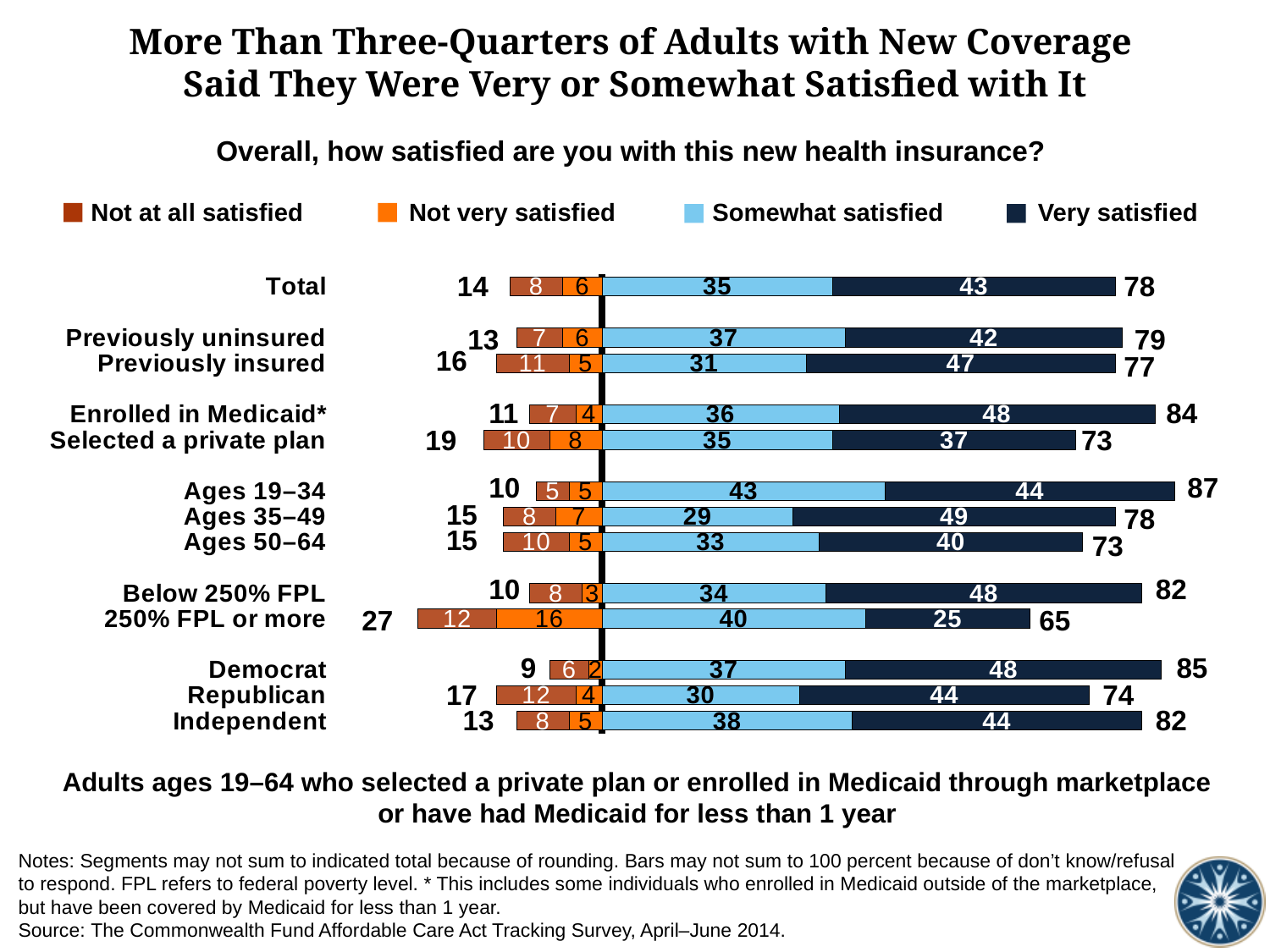
How many groups (bars) are shown in the chart? 13 What is the difference between the very satisfied percentages for Democrats and Republicans? 4 What type of chart is shown on the slide? Stacked bar chart Which group has the highest combined share of very or somewhat satisfied respondents? Ages 19–34 Which group has the lowest combined share of very or somewhat satisfied respondents? 250% FPL or more What percentage of adults with incomes of 250% FPL or more said they were not very satisfied? 16 Which legend entry is shown in the darkest (navy) colour? Very satisfied What is the combined percentage of not at all satisfied and not very satisfied respondents shown for the Previously insured group? 16 What percentage of Republicans said they were somewhat satisfied? 30 What percentage of the Total group said they were very satisfied with their new health insurance? 43 Which group has a larger share of very satisfied respondents: Enrolled in Medicaid* or Selected a private plan? Enrolled in Medicaid* How many response categories does the legend list? 4